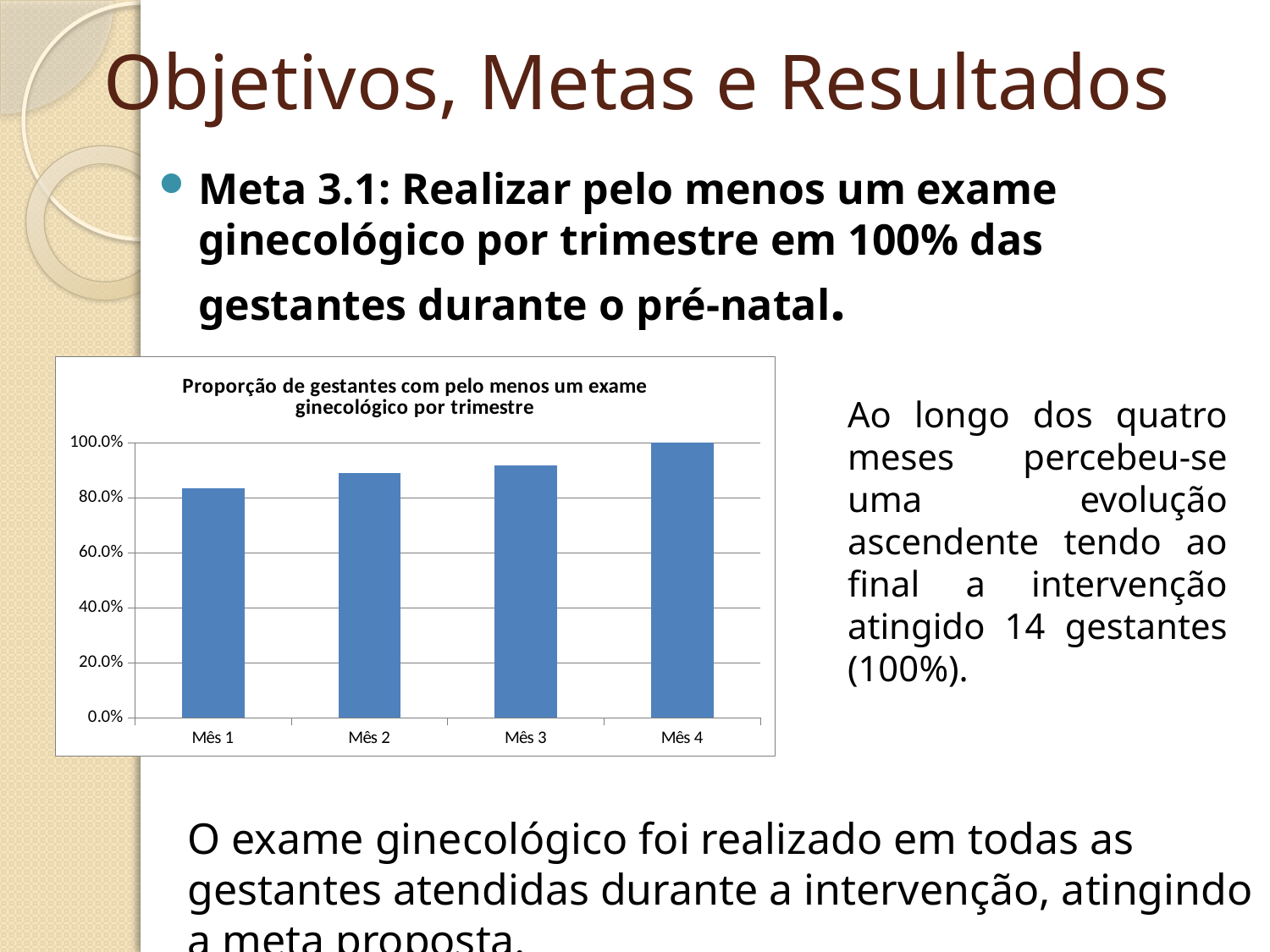
What is the title of the chart? Proporção de gestantes com pelo menos um exame ginecológico por trimestre Which is larger, the value for Mês 2 or the value for Mês 3? Mês 3 Do the values rise or fall from Mês 1 to Mês 4? rise What kind of chart is shown on the slide? bar chart What is the value for Mês 4 in the chart? 100.0% How many categories (months) are plotted on the x axis of the chart? 4 Which is larger, the value for Mês 1 or the value for Mês 4? Mês 4 Which month has the highest proportion of pregnant women with at least one gynecological exam per trimester? Mês 4 Is the value for Mês 3 greater or less than 80.0%? greater Which month has the lowest proportion in the chart? Mês 1 Is the value for Mês 1 greater or less than 60.0%? greater Is the value for Mês 2 greater or less than 100.0%? less